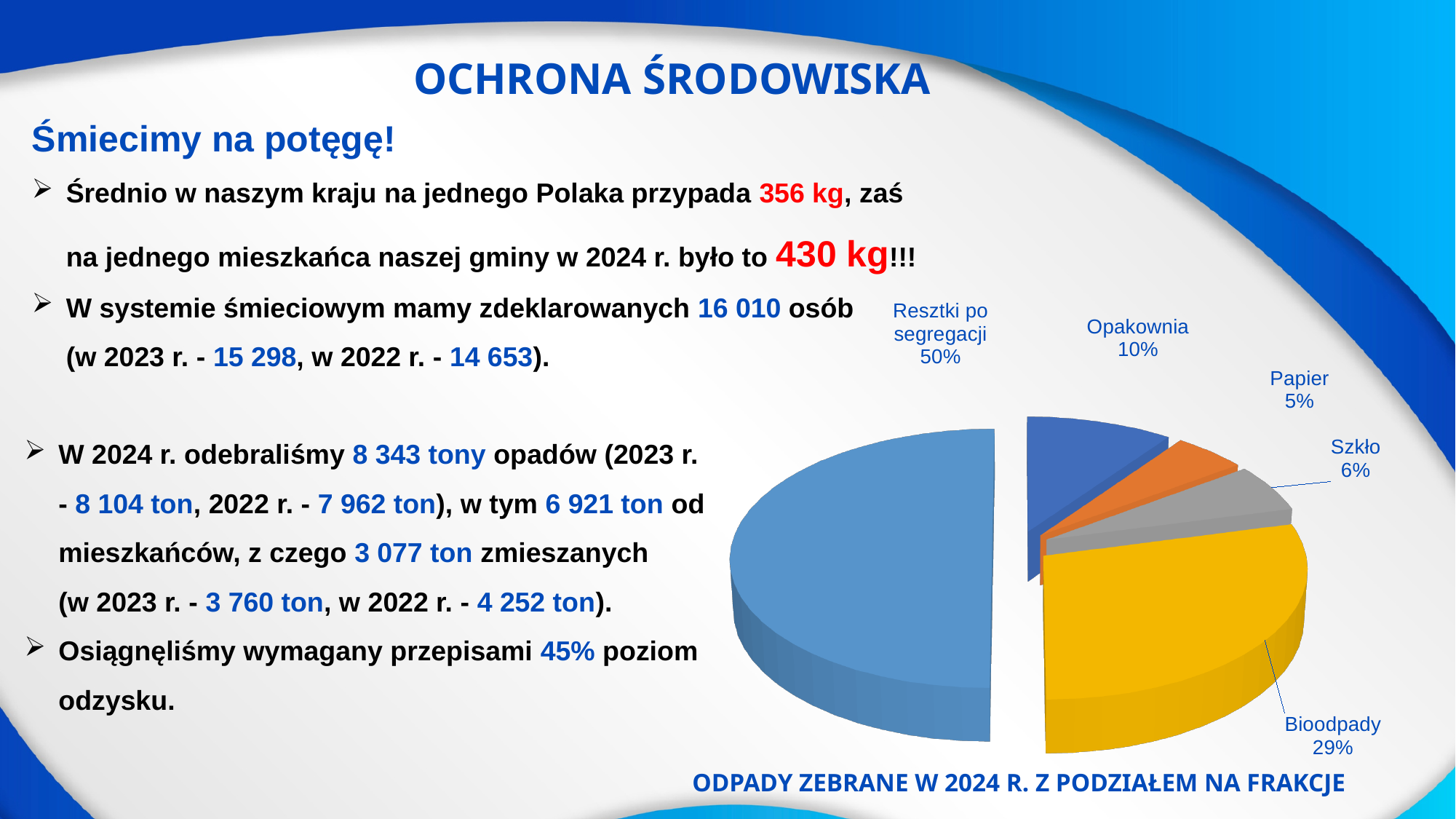
What share of the pie does Opakownia have? 10% Which is larger, the share for Opakownia or the share for Szkło? Opakownia How many categories are shown in the pie chart? 5 Which category has the smallest slice of the pie? Papier What share of the pie does Bioodpady have? 29% What share of the pie does Papier have? 5% What is the title of the pie chart? ODPADY ZEBRANE W 2024 R. Z PODZIAŁEM NA FRAKCJE Which category has the largest slice of the pie? Resztki po segregacji What is the difference in percentage points between Resztki po segregacji and Bioodpady? 21 What kind of chart is shown on the slide? pie chart